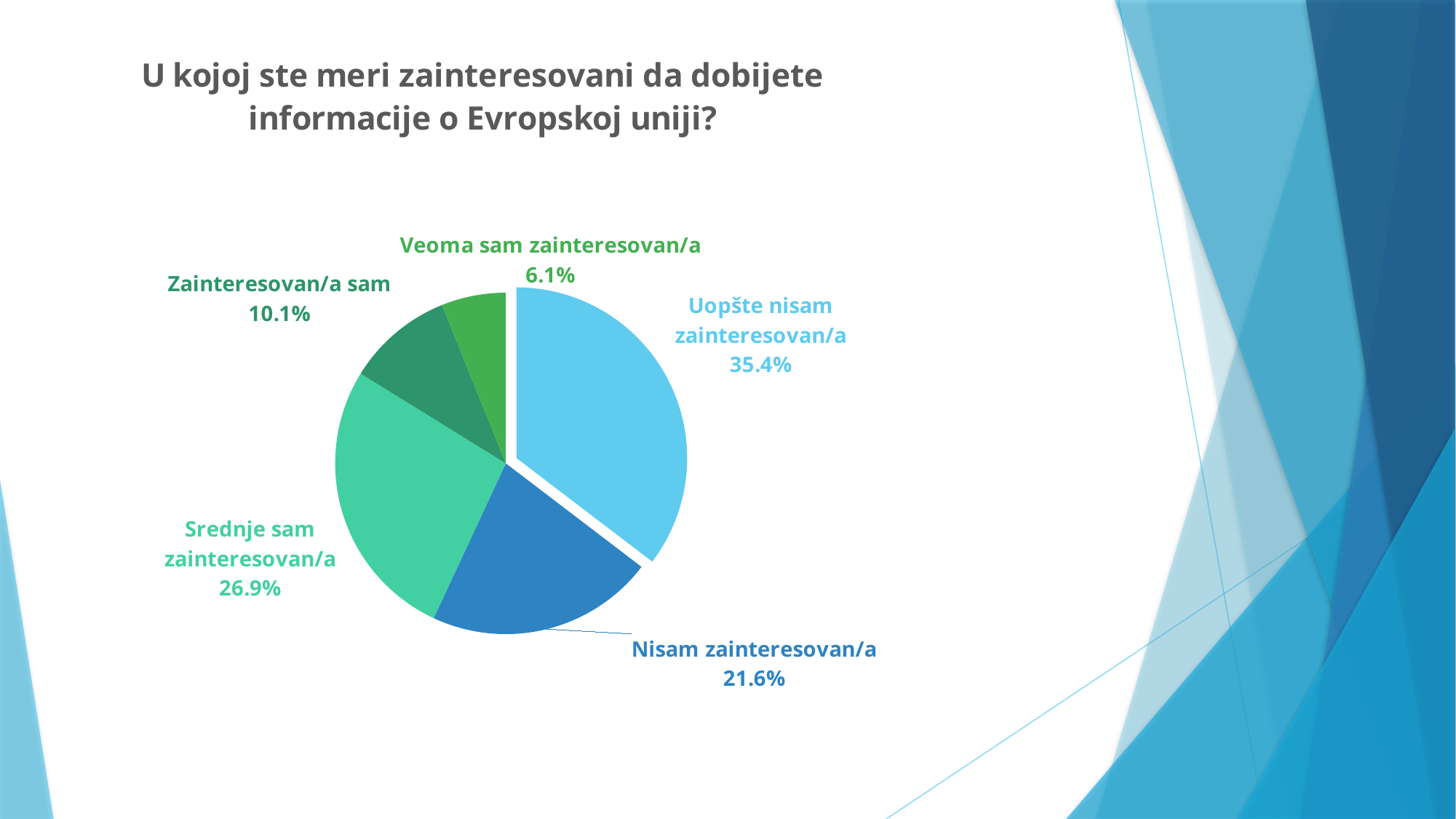
How many slices does the pie chart have? 5 What is the value for "Uopšte nisam zainteresovan/a"? 35.4% Which is larger, "Srednje sam zainteresovan/a" or "Nisam zainteresovan/a"? Srednje sam zainteresovan/a What is the value for "Veoma sam zainteresovan/a"? 6.1% What is the title of the chart? U kojoj ste meri zainteresovani da dobijete informacije o Evropskoj uniji? What is the value for "Zainteresovan/a sam"? 10.1% What kind of chart is shown on the slide? pie chart What is the value for "Nisam zainteresovan/a"? 21.6% What is the difference between the values for "Uopšte nisam zainteresovan/a" and "Nisam zainteresovan/a"? 13.8% Which category has the smallest share of the pie? Veoma sam zainteresovan/a What is the value for "Srednje sam zainteresovan/a"? 26.9% Which category has the largest share of the pie? Uopšte nisam zainteresovan/a